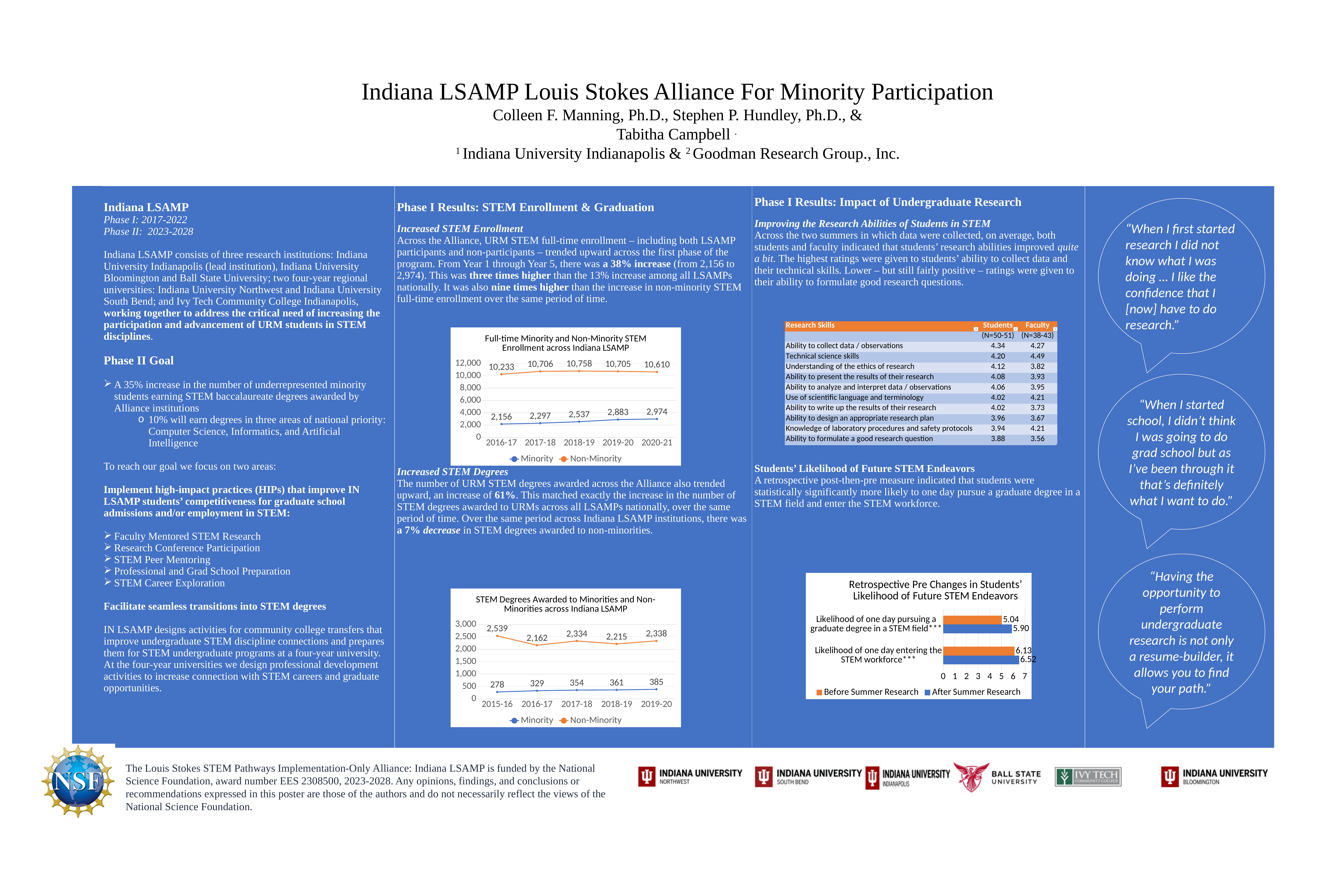
In the 'STEM Degrees Awarded to Minorities and Non-Minorities across Indiana LSAMP' chart, how many years are shown on the x axis? 5 In the 'Retrospective Pre Changes in Students' Likelihood of Future STEM Endeavors' chart, what is the After Summer Research value for likelihood of one day pursuing a graduate degree in a STEM field? 5.90 In the 'Retrospective Pre Changes in Students' Likelihood of Future STEM Endeavors' chart, what is the difference between the After and Before Summer Research values for likelihood of one day entering the STEM workforce? 0.39 In the 'STEM Degrees Awarded to Minorities and Non-Minorities across Indiana LSAMP' chart, what type of chart is it? line chart In the 'STEM Degrees Awarded to Minorities and Non-Minorities across Indiana LSAMP' chart, what is the Minority value for 2019-20? 385 In the 'Full-time Minority and Non-Minority STEM Enrollment across Indiana LSAMP' chart, what is the difference between Minority enrollment in 2020-21 and 2016-17? 818 In the 'Retrospective Pre Changes in Students' Likelihood of Future STEM Endeavors' chart, what type of chart is it? bar chart In the 'Full-time Minority and Non-Minority STEM Enrollment across Indiana LSAMP' chart, how many series does the legend list? 2 In the 'Full-time Minority and Non-Minority STEM Enrollment across Indiana LSAMP' chart, does the Minority series rise or fall from 2016-17 to 2020-21? rise In the 'Full-time Minority and Non-Minority STEM Enrollment across Indiana LSAMP' chart, what is the Minority enrollment value for 2016-17? 2,156 In the 'Full-time Minority and Non-Minority STEM Enrollment across Indiana LSAMP' chart, which year has the highest Non-Minority enrollment? 2018-19 In the 'STEM Degrees Awarded to Minorities and Non-Minorities across Indiana LSAMP' chart, which year has the lowest Non-Minority value? 2016-17